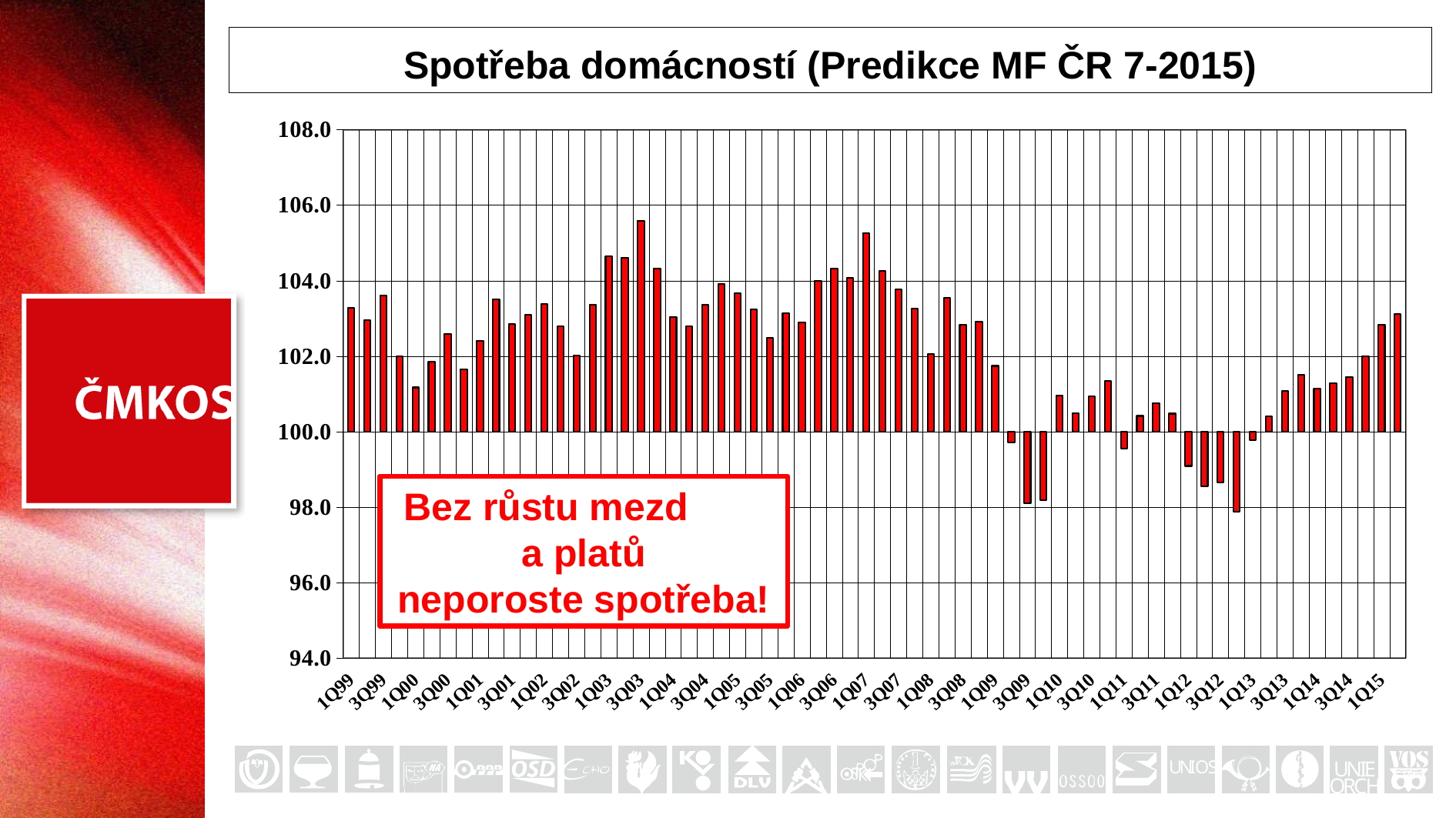
Is the value for 1Q99 greater or less than 102.0? greater Is the value for 3Q12 greater or less than 100.0? less Which labeled quarter has the highest value in the chart? 3Q03 Is the value for 1Q15 greater or less than 102.0? greater What text is written in the red-bordered box overlaid on the chart? Bez růstu mezd a platů neporoste spotřeba! What kind of chart is shown on the slide? bar chart Which is larger, the value for 3Q03 or the value for 1Q13? 3Q03 Do the values generally rise or fall between 1Q07 and 1Q13? fall Which labeled quarter has the lowest value in the chart? 3Q09 What is the title of the chart? Spotřeba domácností (Predikce MF ČR 7-2015)